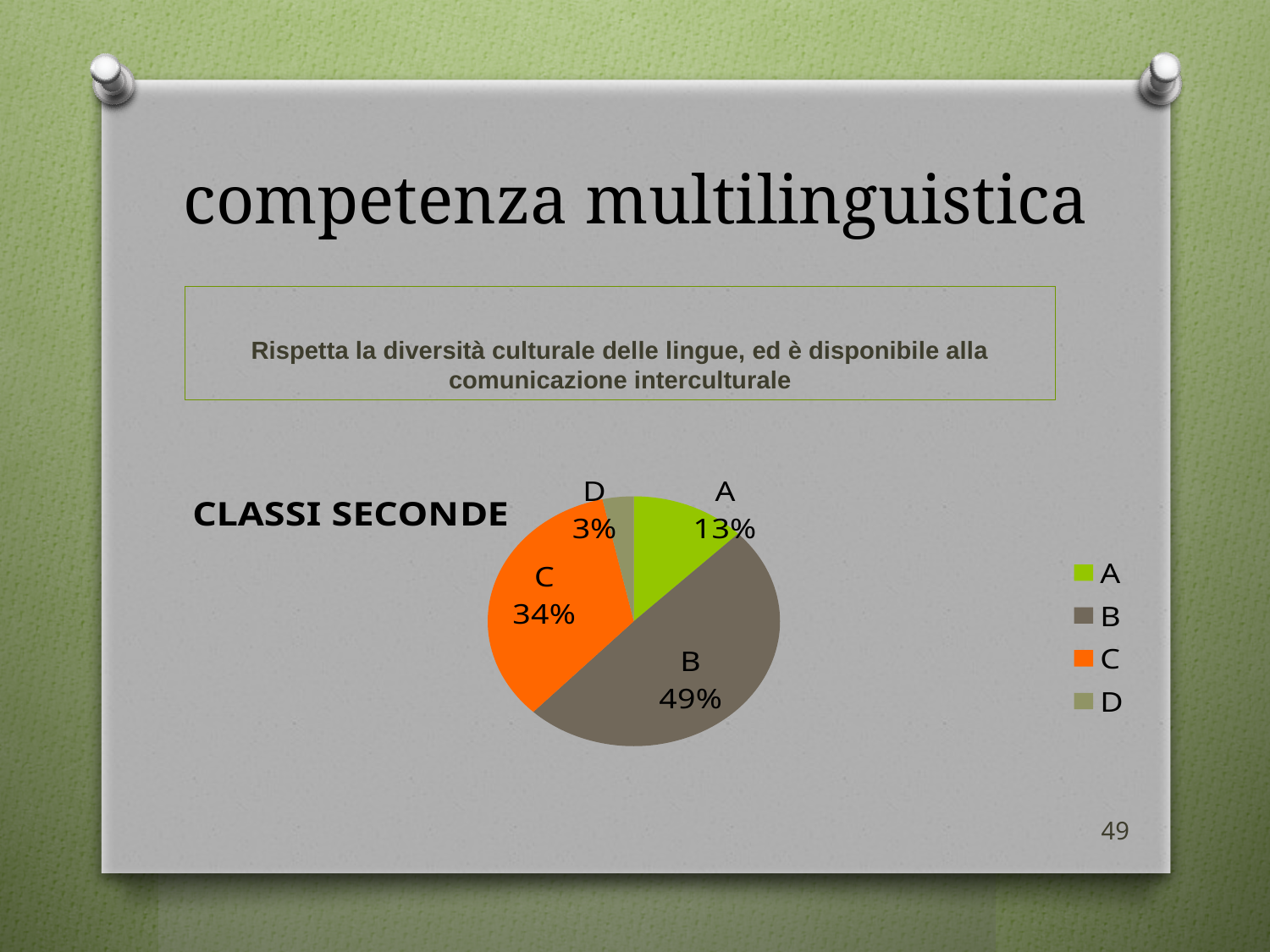
What kind of chart is shown on the slide? pie chart What percentage does slice A represent in the pie chart? 13% How many entries does the legend list? 4 What colour is slice C in the pie chart? orange Which category has the smallest share of the pie chart? D Which category has the largest share of the pie chart? B Which is larger, the share for A or the share for C? C What percentage does slice C represent in the pie chart? 34% How many slices does the pie chart have? 4 What is the difference in percentage points between slice B and slice C? 15 What percentage does slice B represent in the pie chart? 49% What percentage does slice D represent in the pie chart? 3%